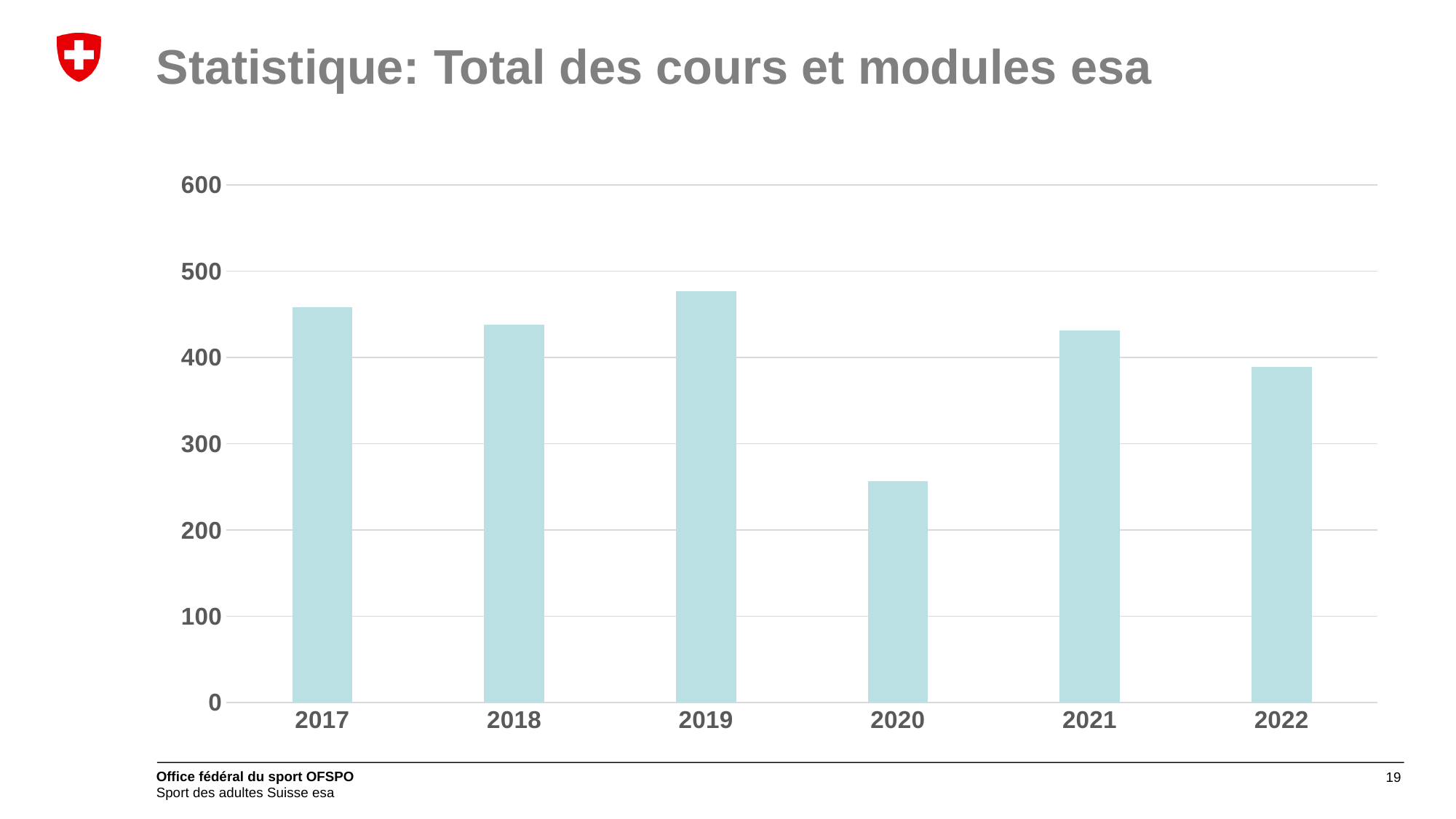
Is the value for 2022 greater or less than 300? greater Do the values rise or fall from 2019 to 2020? fall What is the title of the slide containing the chart? Statistique: Total des cours et modules esa What kind of chart is shown on the slide? bar chart Is the value for 2017 greater or less than 400? greater How many years are shown on the x axis of the chart? 6 Which is larger, the value for 2017 or the value for 2018? 2017 Which is larger, the value for 2021 or the value for 2022? 2021 Which year has the highest bar in the chart? 2019 Is the value for 2019 greater or less than 500? less Which year has the lowest bar in the chart? 2020